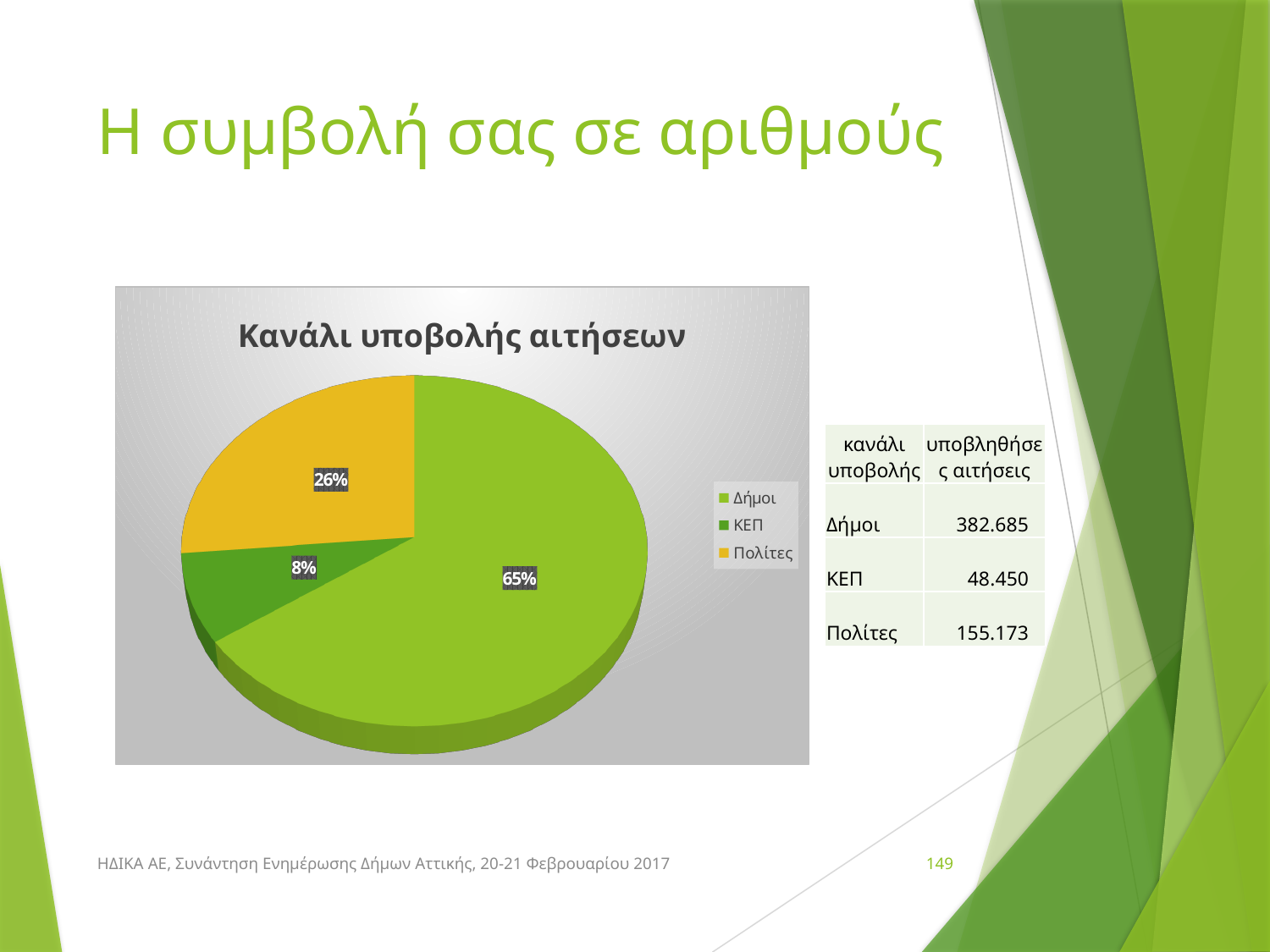
Which category has the largest slice of the pie? Δήμοι What is the title of the pie chart? Κανάλι υποβολής αιτήσεων What kind of chart is shown on the slide? pie chart How many entries does the legend of the pie chart list? 3 What share of the pie does Πολίτες have? 26% Which legend entry is shown in yellow/orange in the pie chart? Πολίτες What share of the pie does ΚΕΠ have? 8% Which category has the smallest slice of the pie? ΚΕΠ Which slice is larger, Πολίτες or ΚΕΠ? Πολίτες What is the difference in percentage points between the Δήμοι slice and the Πολίτες slice? 39 How many slices does the pie chart have? 3 What share of the pie does Δήμοι have? 65%